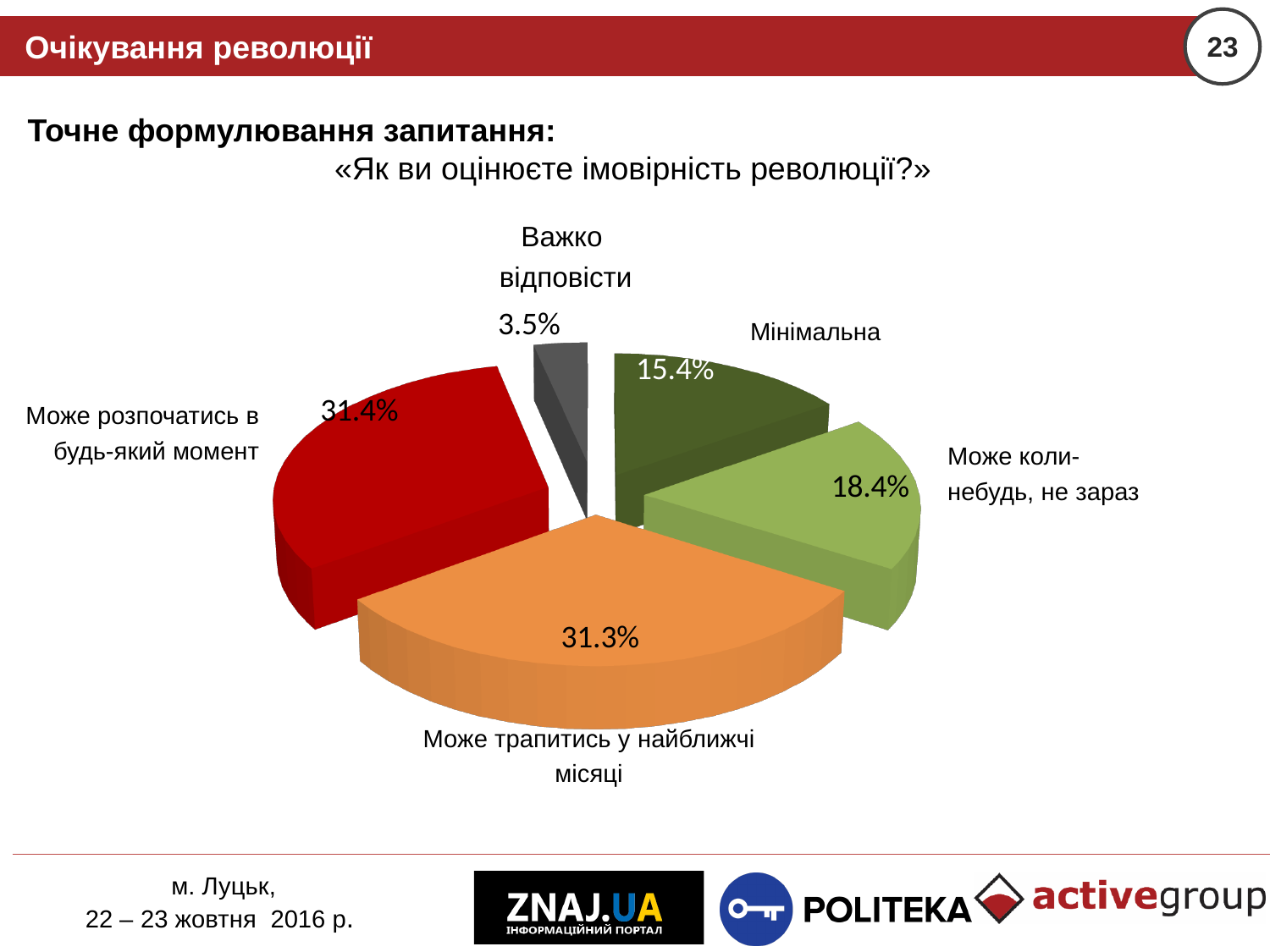
How many slices does the pie chart have? 5 What percentage is shown for «Може трапитись у найближчі місяці»? 31.3% What percentage is shown for «Може коли-небудь, не зараз»? 18.4% Which is larger: «Мінімальна» or «Може коли-небудь, не зараз»? Може коли-небудь, не зараз What percentage is shown for «Важко відповісти»? 3.5% What kind of chart is shown on the slide? Pie chart What survey question is the pie chart based on, as stated on the slide? «Як ви оцінюєте імовірність революції?» What is the difference in percentage points between «Може розпочатись в будь-який момент» and «Важко відповісти»? 27.9 Which category has the smallest slice of the pie? Важко відповісти What percentage is shown for «Мінімальна»? 15.4% What is the difference in percentage points between «Може трапитись у найближчі місяці» and «Може коли-небудь, не зараз»? 12.9 What percentage is shown for «Може розпочатись в будь-який момент»? 31.4%